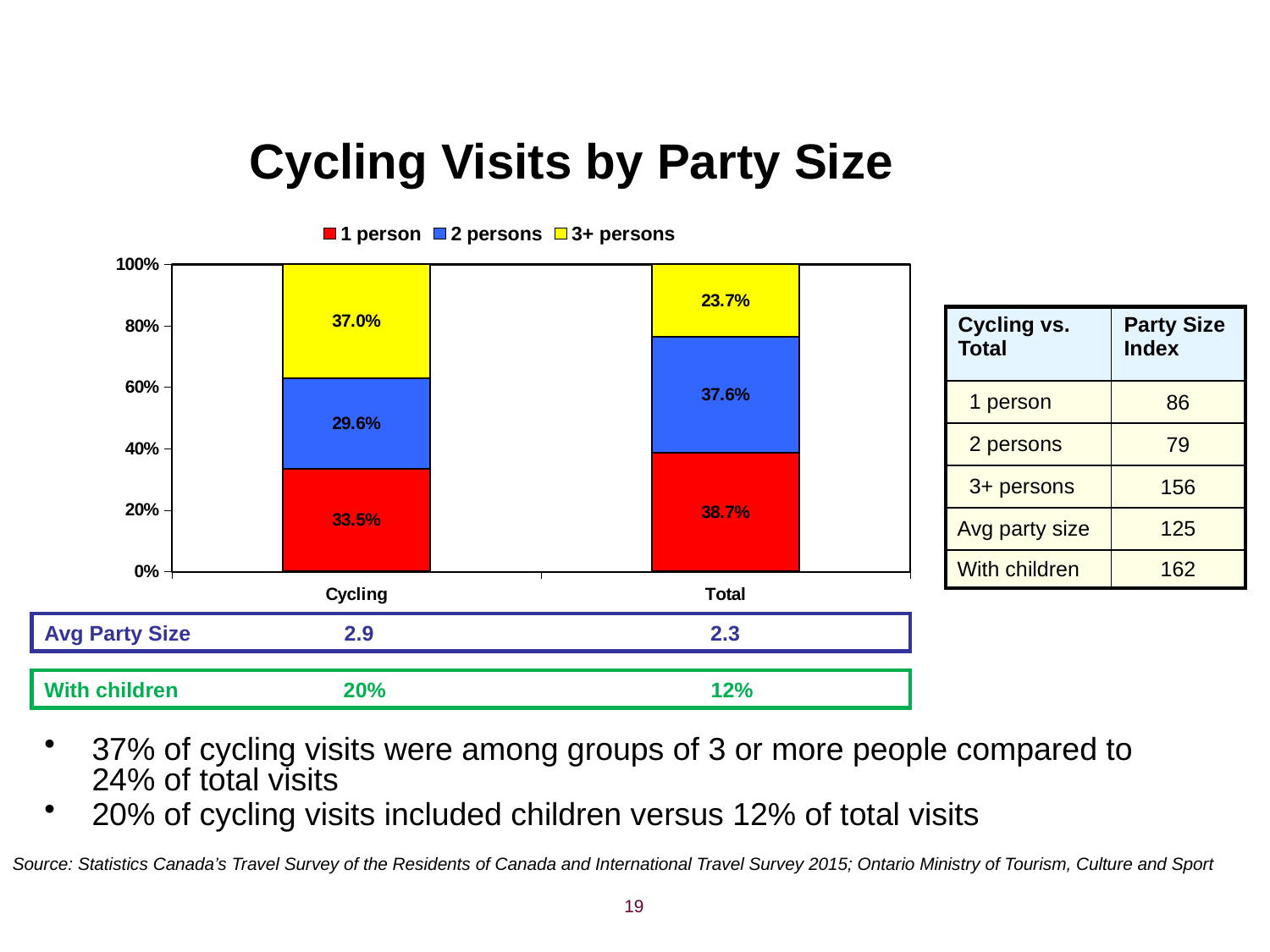
What is the difference between the 3+ persons share for Cycling and for Total? 13.3% How many categories are shown on the x axis of the chart? 2 What percentage of Total visits were by 3+ persons parties? 23.7% How many series does the chart legend list? 3 What kind of chart is shown on the slide? Stacked bar chart Which party size segment is the largest for Total visits? 1 person Which is larger: the 2 persons share for Cycling or for Total? Total What percentage of Cycling visits were by 3+ persons parties? 37.0% What colour represents the 1 person series in the chart? Red Which party size segment is the smallest for Cycling visits? 2 persons What percentage of Cycling visits were by 2 persons parties? 29.6% What percentage of Total visits were by 1 person parties? 38.7%